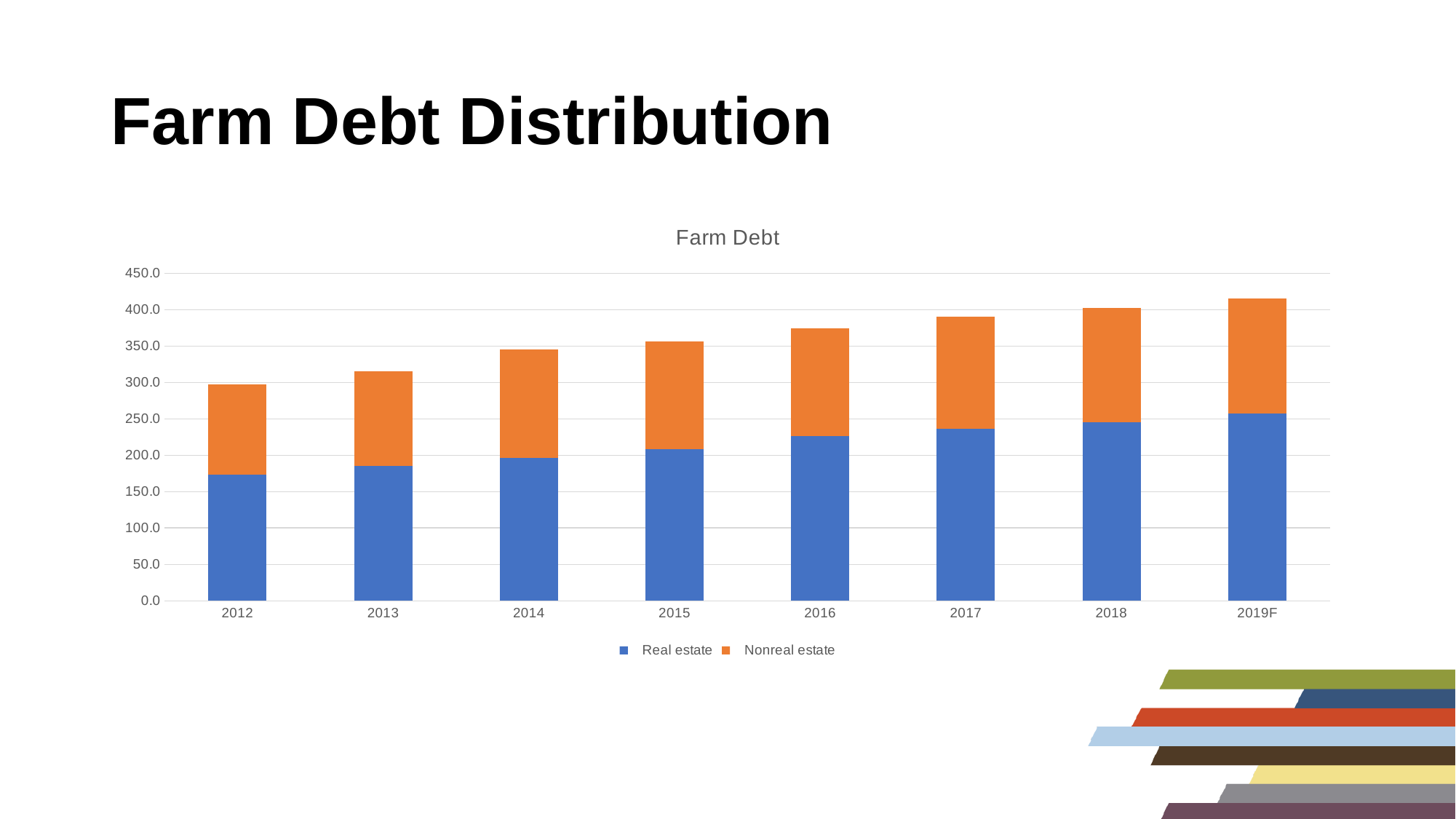
Is the Real estate value for 2016 greater or less than 200.0? greater What type of chart is shown on the slide? Stacked bar chart Which year has the highest total farm debt bar? 2019F Is the total farm debt for 2019F greater or less than 400.0? greater What is the title of the chart? Farm Debt Which year has the lowest total farm debt bar? 2012 What are the two series named in the legend? Real estate and Nonreal estate How many years (categories) are shown on the x axis? 8 Is the Real estate value for 2012 greater or less than 200.0? less How many series does the legend list? 2 Do the total farm debt bars rise or fall from 2012 to 2019F? Rise